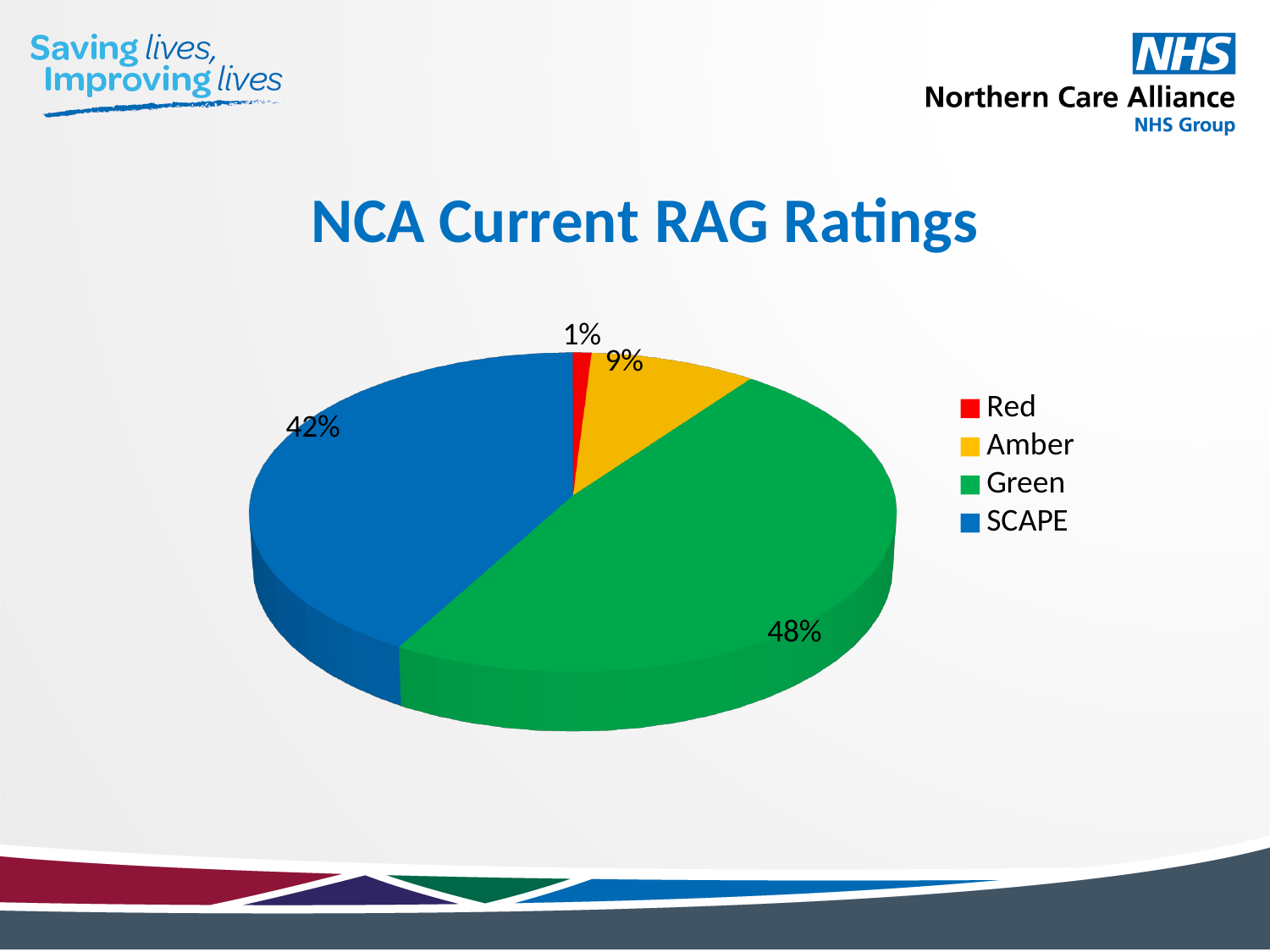
What share of the pie does the Amber slice represent? 9% What share of the pie does the Red slice represent? 1% What share of the pie does the SCAPE slice represent? 42% Which is larger, the Amber slice or the Red slice? Amber Which category has the largest slice of the pie? Green What colour is used for the SCAPE slice? Blue What is the title of the chart? NCA Current RAG Ratings What kind of chart is shown on the slide? Pie chart How many categories does the legend list? 4 Which category has the smallest slice of the pie? Red What is the difference in percentage points between the Green and SCAPE slices? 6